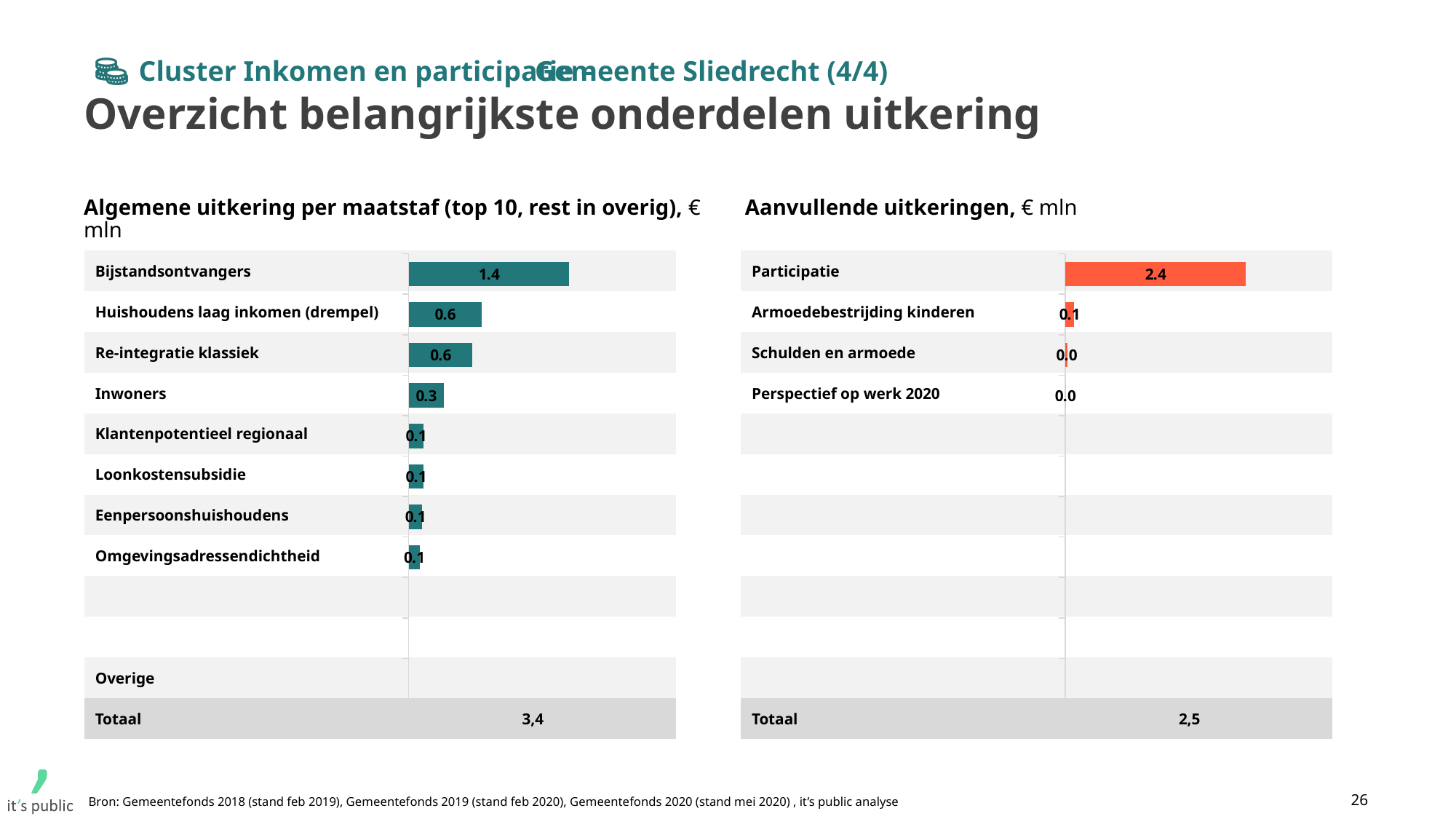
In the 'Algemene uitkering per maatstaf' chart, what is the difference between Bijstandsontvangers and Huishoudens laag inkomen (drempel)? 0.8 In the 'Algemene uitkering per maatstaf' chart, what is the value for Bijstandsontvangers? 1.4 In the 'Algemene uitkering per maatstaf' chart, which category has the highest value? Bijstandsontvangers In the 'Algemene uitkering per maatstaf' chart, what is the value for Inwoners? 0.3 In the 'Aanvullende uitkeringen' chart, what is the Totaal value shown? 2,5 In the 'Aanvullende uitkeringen' chart, which category has the highest value? Participatie Which is larger: Participatie in the 'Aanvullende uitkeringen' chart or Bijstandsontvangers in the 'Algemene uitkering per maatstaf' chart? Participatie What kind of chart is the 'Aanvullende uitkeringen' chart? Bar chart In the 'Aanvullende uitkeringen' chart, how many categories are listed? 4 In the 'Algemene uitkering per maatstaf' chart, what is the Totaal value shown? 3,4 In the 'Aanvullende uitkeringen' chart, what is the value for Armoedebestrijding kinderen? 0.1 In the 'Aanvullende uitkeringen' chart, what is the value for Participatie? 2.4